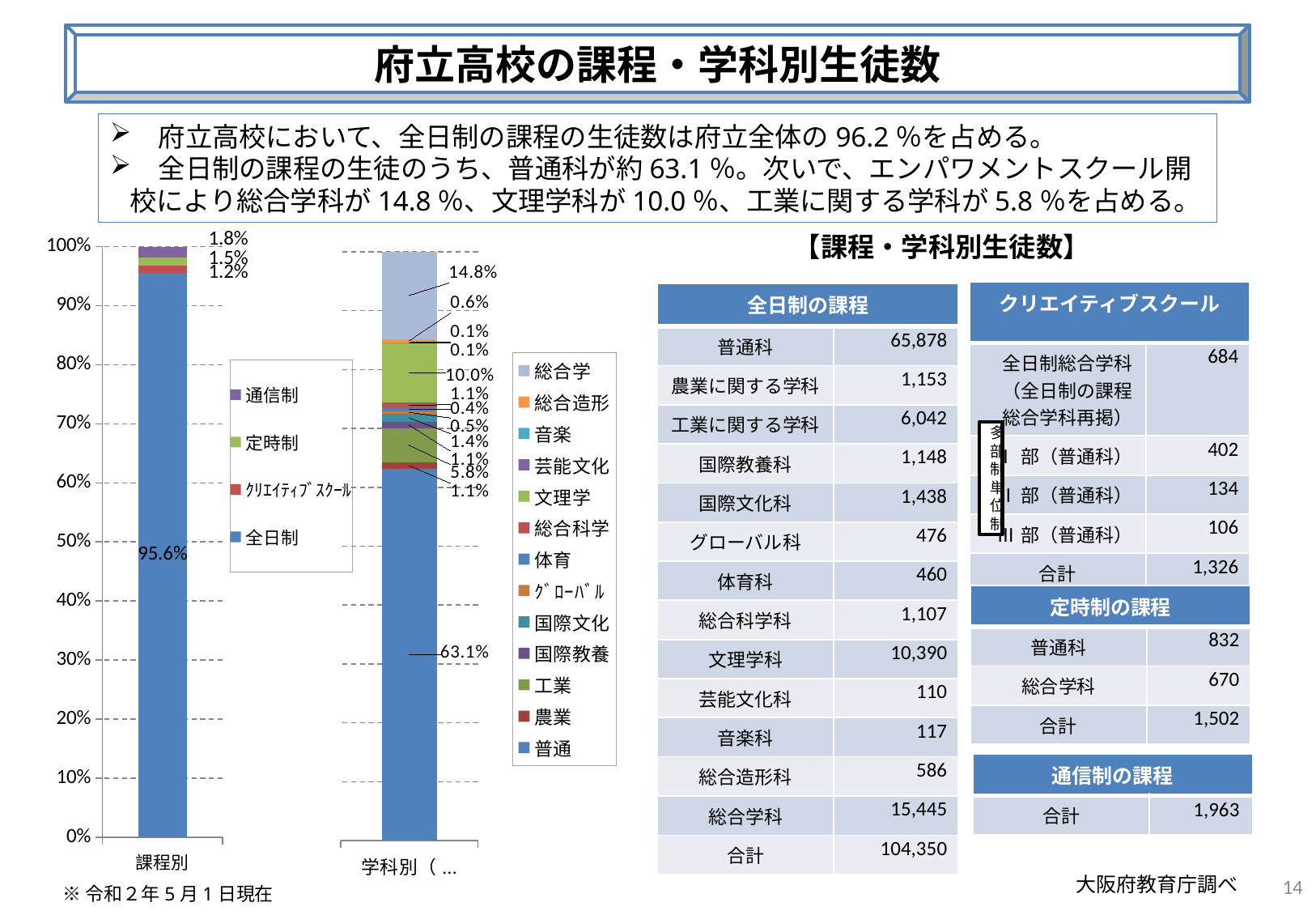
How many series does the legend of the right chart (学科別) list? 13 In the right chart (学科別), what is the difference in percentage points between 普通 (63.1%) and 総合学 (14.8%)? 48.3 percentage points How many series does the legend of the left chart (課程別) list? 4 In the right chart (学科別), which is larger, 総合学 or 文理学? 総合学 In the right chart (学科別), what percentage is shown for 工業? 5.8% In the left chart (課程別), which series has the largest share of the bar? 全日制 In the right chart (学科別), what percentage is shown for 普通? 63.1% In the right chart (学科別), which series has the largest share of the bar? 普通 In the left chart (課程別), what percentage is shown for 全日制? 95.6% What kind of chart is used on the left of the slide (課程別)? Stacked bar chart In the right chart (学科別), what percentage is shown for 総合学? 14.8% In the right chart (学科別), what percentage is shown for 文理学? 10.0%